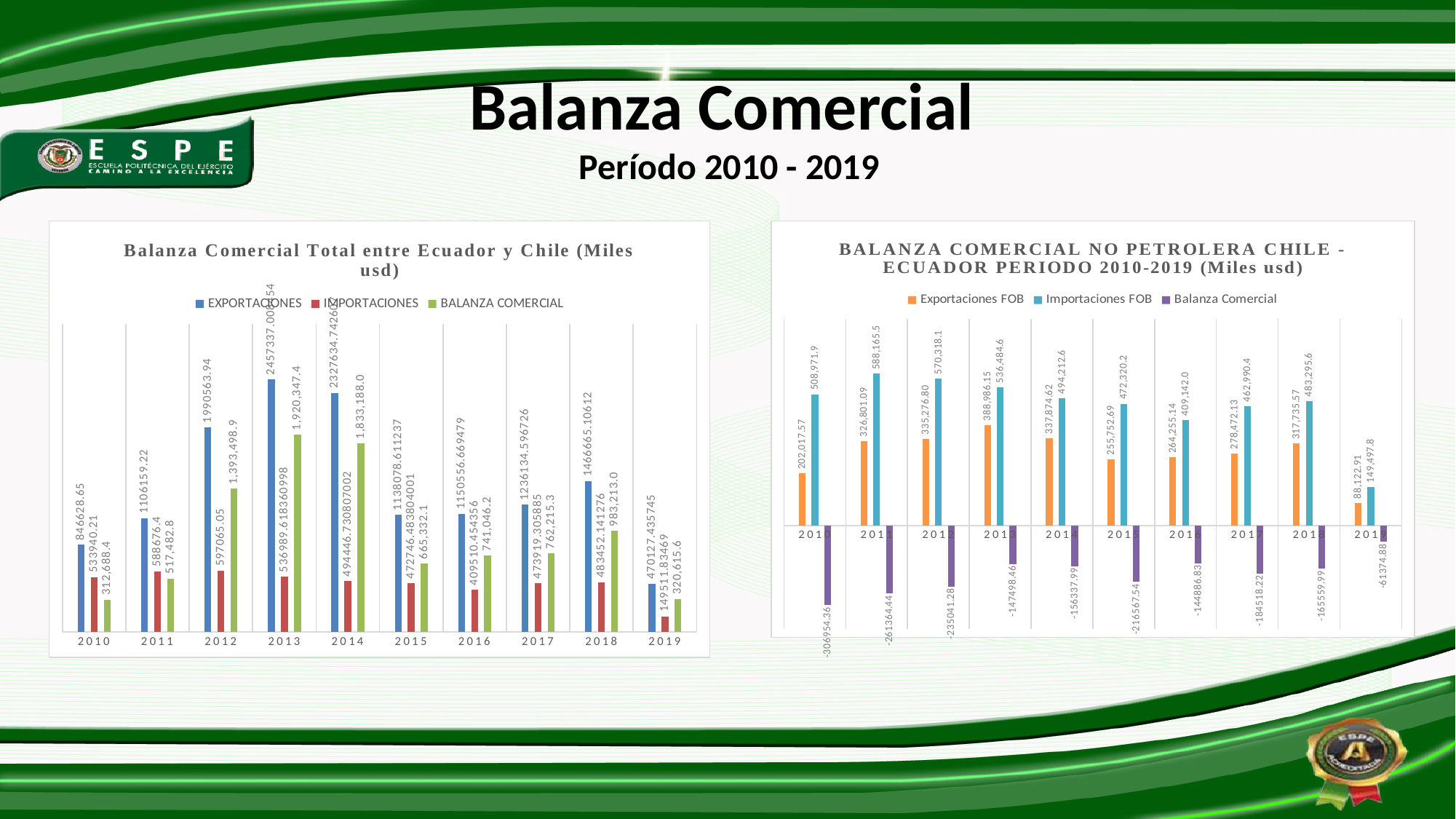
In the left chart, Balanza Comercial Total entre Ecuador y Chile, what is the EXPORTACIONES value for 2012? 1990563.94 In the right chart, Balanza Comercial No Petrolera Chile - Ecuador, what is the Importaciones FOB value for 2011? 588,165.5 What kind of chart is the right chart, Balanza Comercial No Petrolera Chile - Ecuador? Bar chart In the right chart, Balanza Comercial No Petrolera Chile - Ecuador, is the Importaciones FOB value larger in 2012 or in 2016? 2012 In the left chart, Balanza Comercial Total entre Ecuador y Chile, which year has the highest BALANZA COMERCIAL value? 2013 In the right chart, Balanza Comercial No Petrolera Chile - Ecuador, what is the Balanza Comercial value for 2010? -306954.36 In the left chart, Balanza Comercial Total entre Ecuador y Chile, how many series does the legend list? 3 In the right chart, Balanza Comercial No Petrolera Chile - Ecuador, how many years are shown on the x axis? 10 In the right chart, Balanza Comercial No Petrolera Chile - Ecuador, which year has the highest Exportaciones FOB value? 2013 In the left chart, Balanza Comercial Total entre Ecuador y Chile, which year has the lowest EXPORTACIONES value? 2019 In the left chart, Balanza Comercial Total entre Ecuador y Chile, what is the IMPORTACIONES value for 2019? 149511.83469 In the left chart, Balanza Comercial Total entre Ecuador y Chile, what is the BALANZA COMERCIAL value for 2014? 1,833,188.0